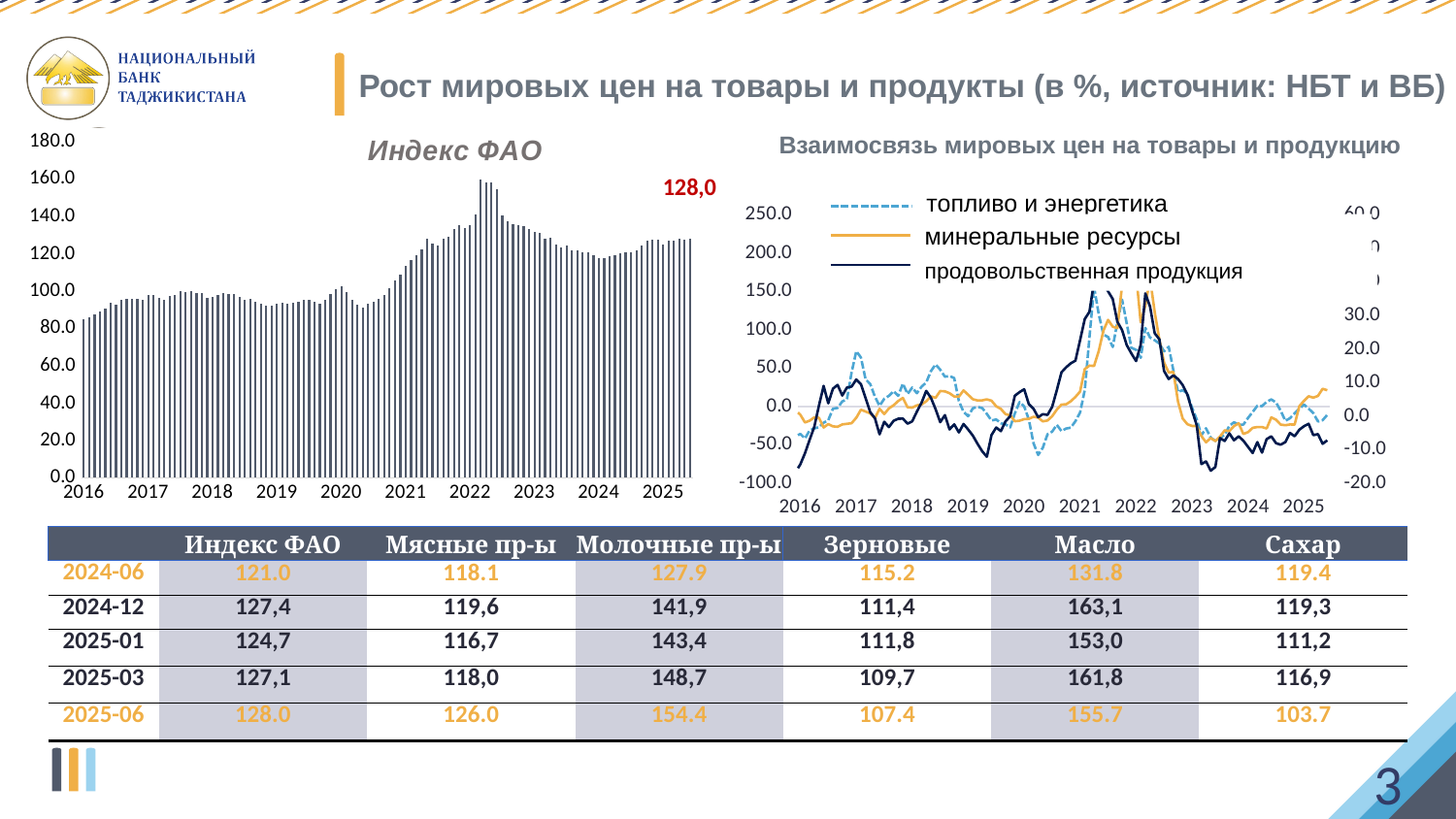
What are the three series named in the legend of the "Взаимосвязь мировых цен на товары и продукцию" chart? топливо и энергетика, минеральные ресурсы, продовольственная продукция What kind of chart is the "Взаимосвязь мировых цен на товары и продукцию" chart on the right of the slide? line chart What is the highest value shown on the vertical axis of the "Индекс ФАО" chart? 180.0 How many series does the legend of the "Взаимосвязь мировых цен на товары и продукцию" chart list? 3 In the "Индекс ФАО" chart, what value is printed as the data label on the last bar? 128,0 In the "Индекс ФАО" chart, do the values rise or fall from 2020 to the peak in 2022? rise What kind of chart is the "Индекс ФАО" chart on the left of the slide? bar chart How many year labels are shown on the x axis of the "Взаимосвязь мировых цен на товары и продукцию" chart? 10 In the "Взаимосвязь мировых цен на товары и продукцию" chart, which series is drawn with a dashed line? топливо и энергетика In the "Индекс ФАО" chart, is the value of the first bar in 2016 greater or less than 100? less In the "Индекс ФАО" chart, is the peak value in 2022 greater or less than 140? greater